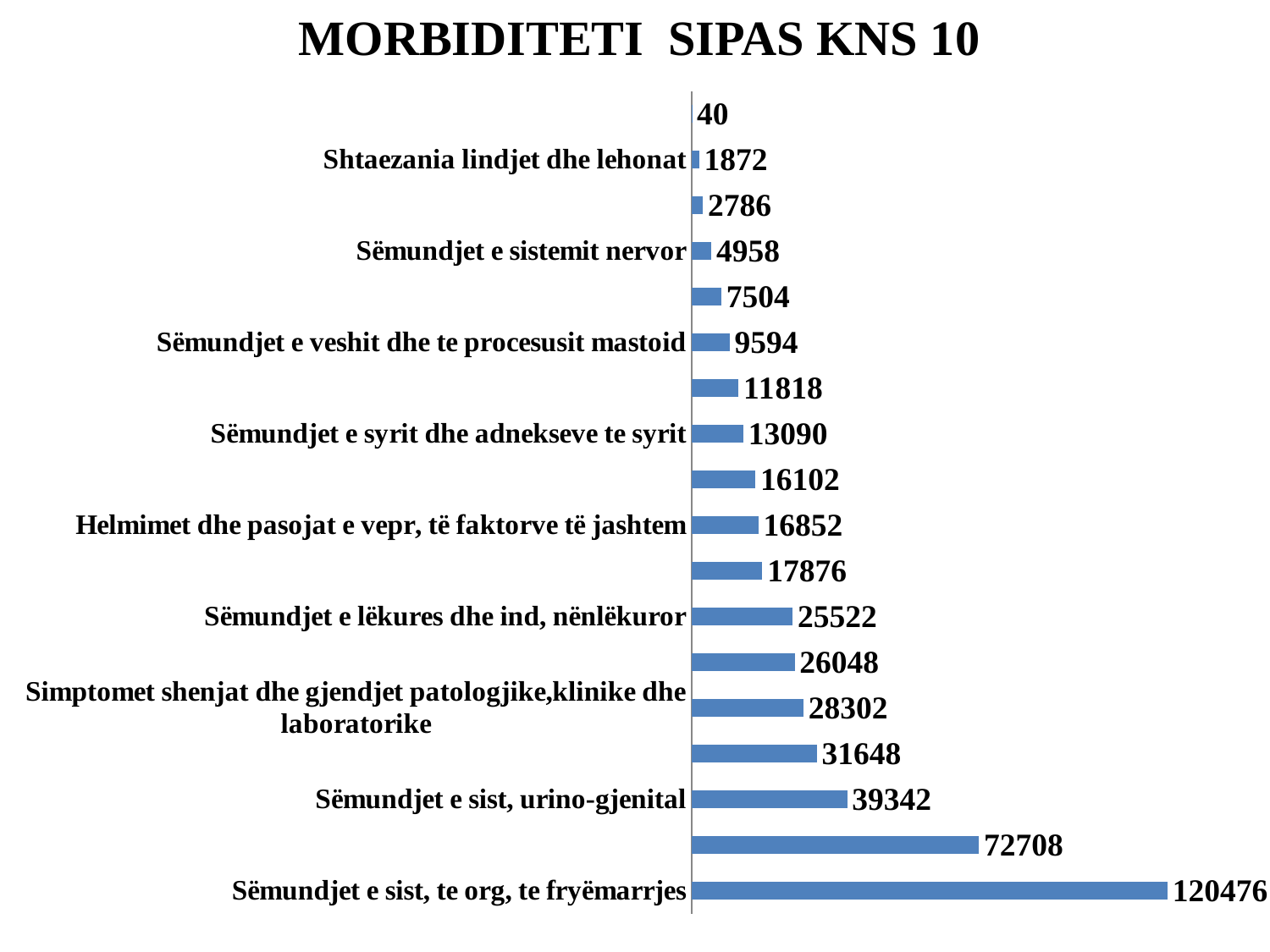
What is the difference between the values for Sëmundjet e veshit dhe te procesusit mastoid and Sëmundjet e sistemit nervor? 4636 What is the value for Sëmundjet e lëkures dhe ind, nënlëkuror? 25522 What is the value for Sëmundjet e sist, te org, te fryëmarrjes? 120476 Which is larger: the value for Sëmundjet e sist, urino-gjenital or the value for Sëmundjet e lëkures dhe ind, nënlëkuror? Sëmundjet e sist, urino-gjenital Which category has the highest value? Sëmundjet e sist, te org, te fryëmarrjes What is the difference between the values for Sëmundjet e sist, te org, te fryëmarrjes and Sëmundjet e sist, urino-gjenital? 81134 What kind of chart is shown on the slide? Bar chart What is the value for Shtaezania lindjet dhe lehonat? 1872 What is the title of the chart? MORBIDITETI SIPAS KNS 10 What is the value for Sëmundjet e sist, urino-gjenital? 39342 What is the value for Sëmundjet e sistemit nervor? 4958 How many bars are plotted in the chart? 18